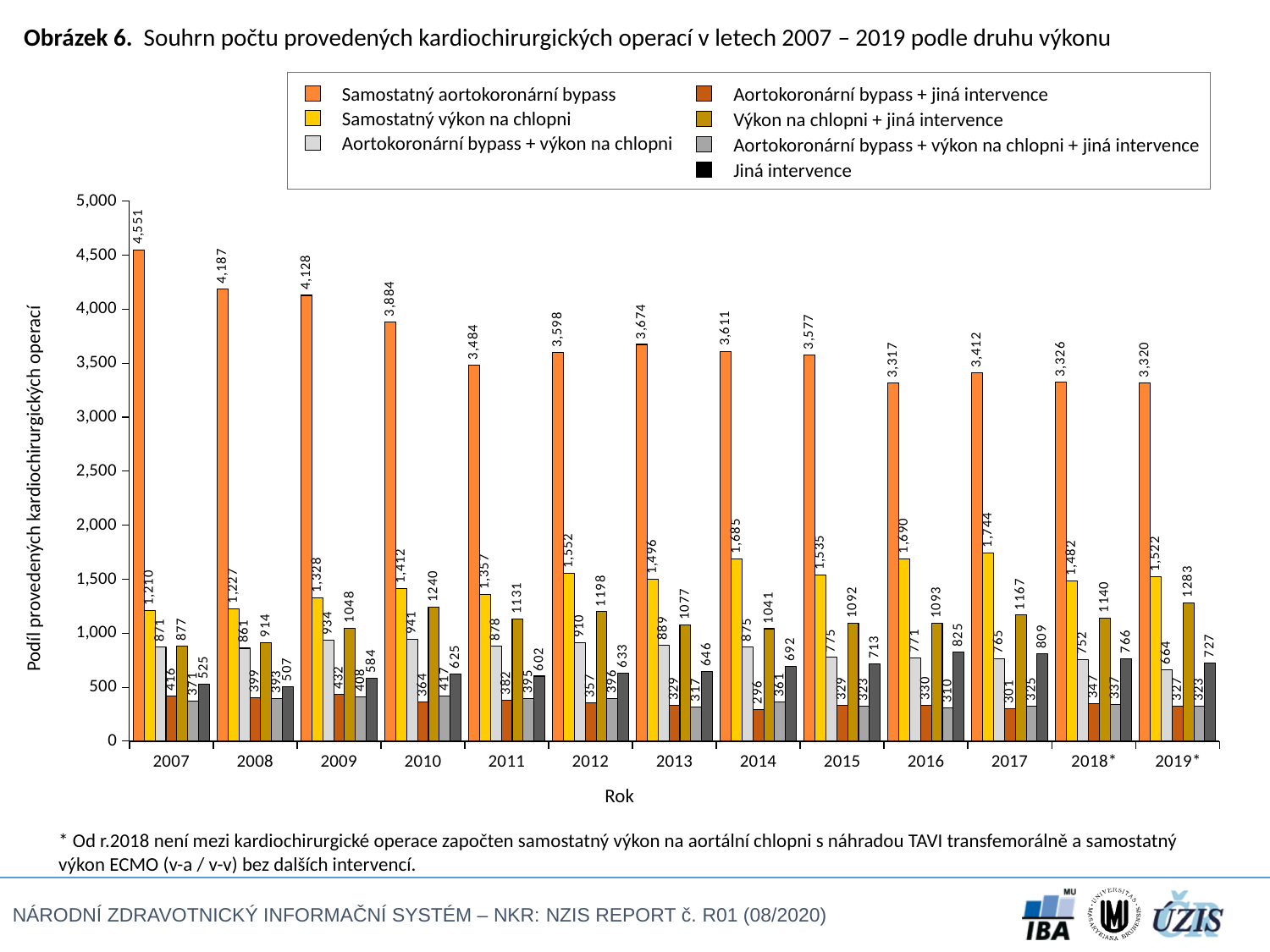
In which year is the value for Samostatný aortokoronární bypass highest? 2007 In which year is the value for Samostatný výkon na chlopni highest? 2017 What is the title of the x axis? Rok What kind of chart is shown on the slide? Bar chart Does the value for Samostatný aortokoronární bypass rise or fall from 2007 to 2011? Fall How many series does the legend list? 7 How many years are shown on the x axis? 13 What is the value for Jiná intervence in 2016? 825 What is the value for Samostatný aortokoronární bypass in 2007? 4,551 What is the value for Výkon na chlopni + jiná intervence in 2019*? 1283 In 2010, which is larger: Samostatný výkon na chlopni or Výkon na chlopni + jiná intervence? Samostatný výkon na chlopni What is the difference between the Samostatný aortokoronární bypass values in 2007 and 2019*? 1,231